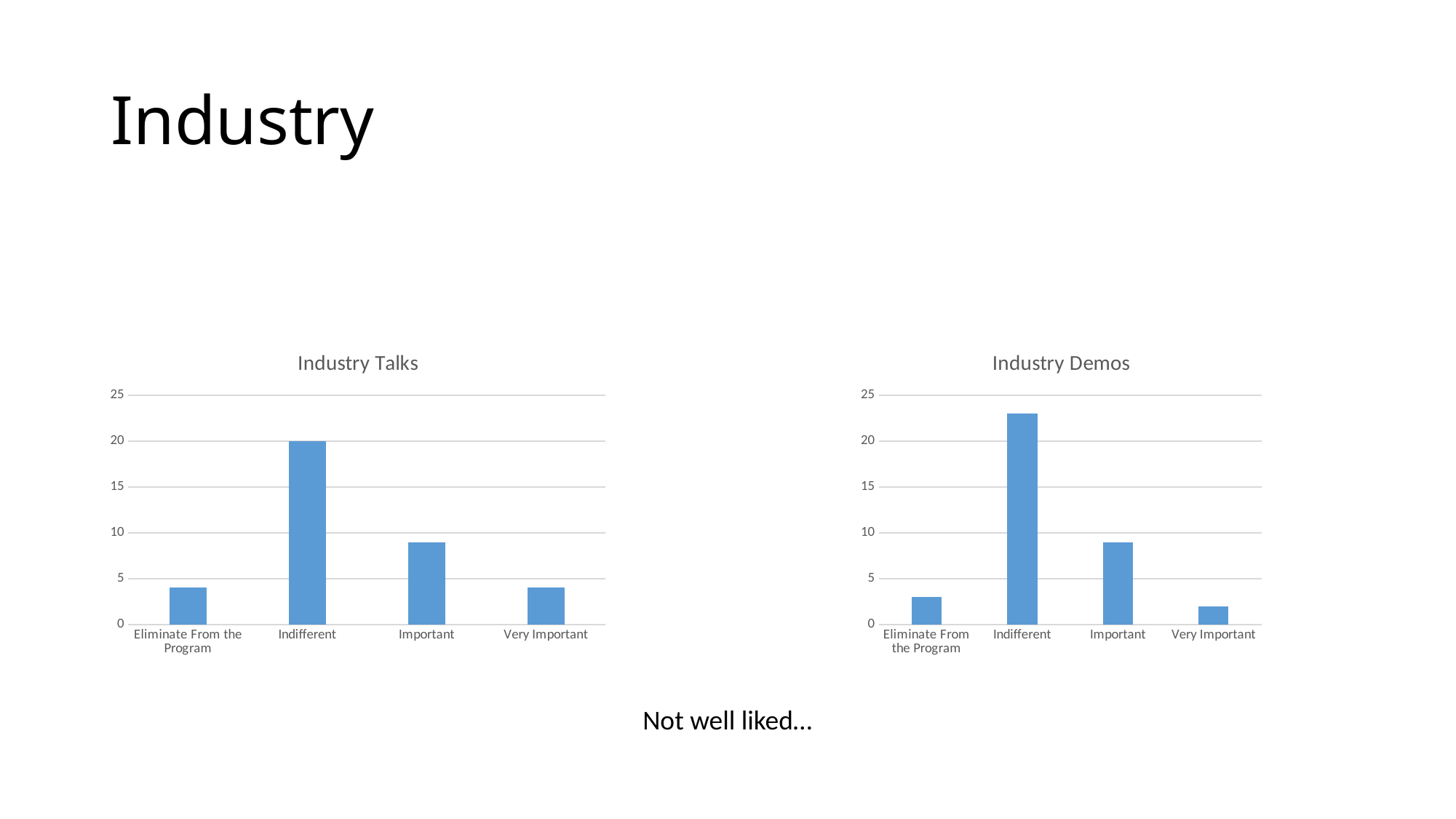
In the Industry Demos chart, which is larger, the value for Indifferent or the value for Important? Indifferent In the Industry Talks chart, which is larger, the value for Important or the value for Very Important? Important In the Industry Demos chart, is the value for Indifferent greater or less than 20? greater In the Industry Demos chart, which category has the highest value? Indifferent In the Industry Talks chart, is the value for Important greater or less than 10? less In the Industry Talks chart, is the value for Eliminate From the Program greater or less than 5? less In the Industry Talks chart, which category has the highest value? Indifferent How many categories are shown on the Industry Demos chart? 4 In the Industry Talks chart, what is the value for Indifferent? 20 What kind of chart is the Industry Talks chart? bar chart What is the title of the chart on the right side of the slide? Industry Demos